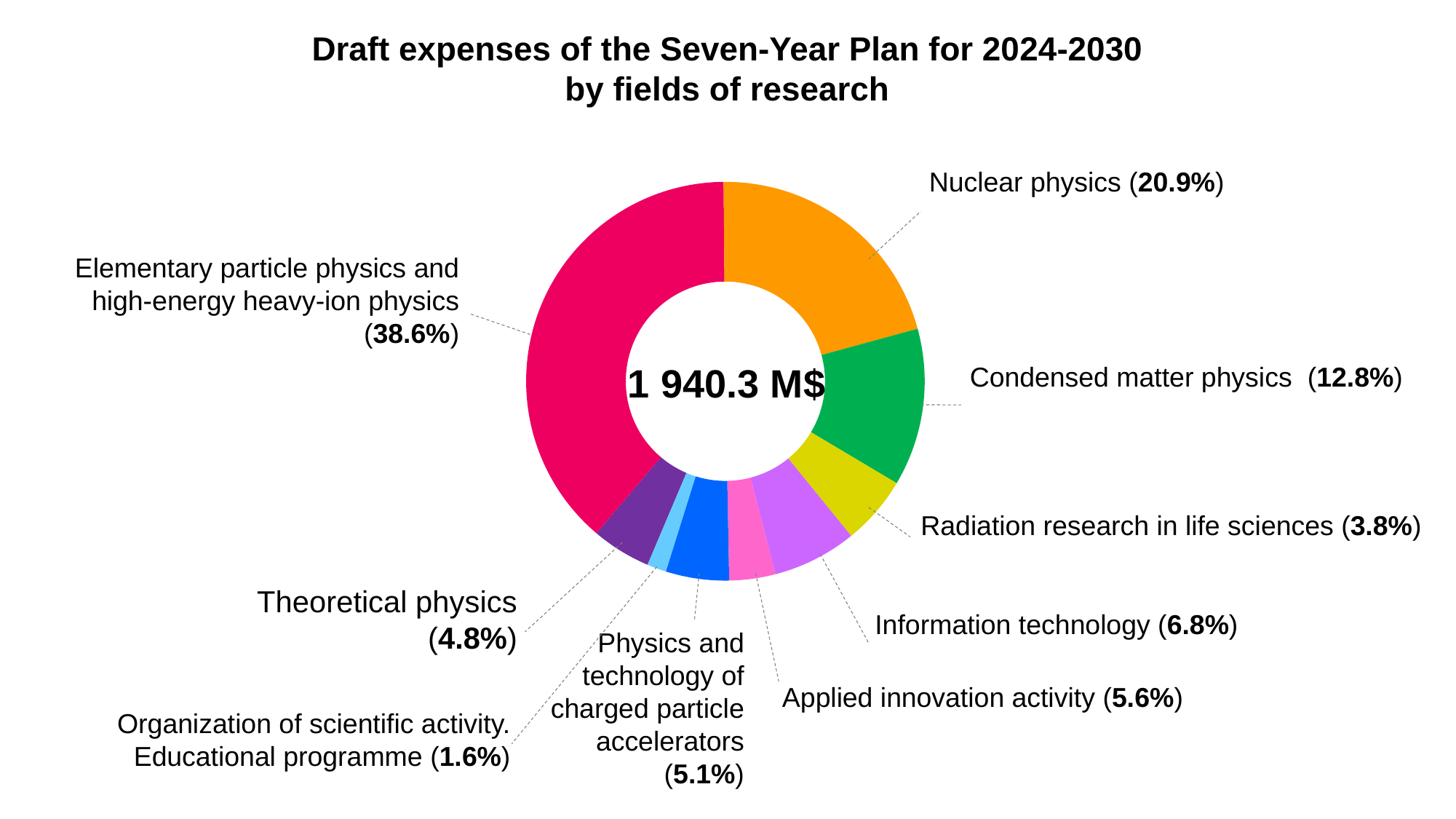
What share of the draft expenses goes to Theoretical physics? 4.8% What is the title of the chart? Draft expenses of the Seven-Year Plan for 2024-2030 by fields of research Which field of research has the smallest share of the draft expenses? Organization of scientific activity. Educational programme Which field of research has the largest share of the draft expenses? Elementary particle physics and high-energy heavy-ion physics What share of the draft expenses goes to Condensed matter physics? 12.8% Which has a larger share: Applied innovation activity or Physics and technology of charged particle accelerators? Applied innovation activity What share of the draft expenses goes to Nuclear physics? 20.9% How many fields of research are shown in the chart? 9 How many percentage points larger is the share for Nuclear physics than for Condensed matter physics? 8.1 What type of chart is shown on the slide? Pie chart (donut) What total amount is shown in the centre of the chart? 1 940.3 M$